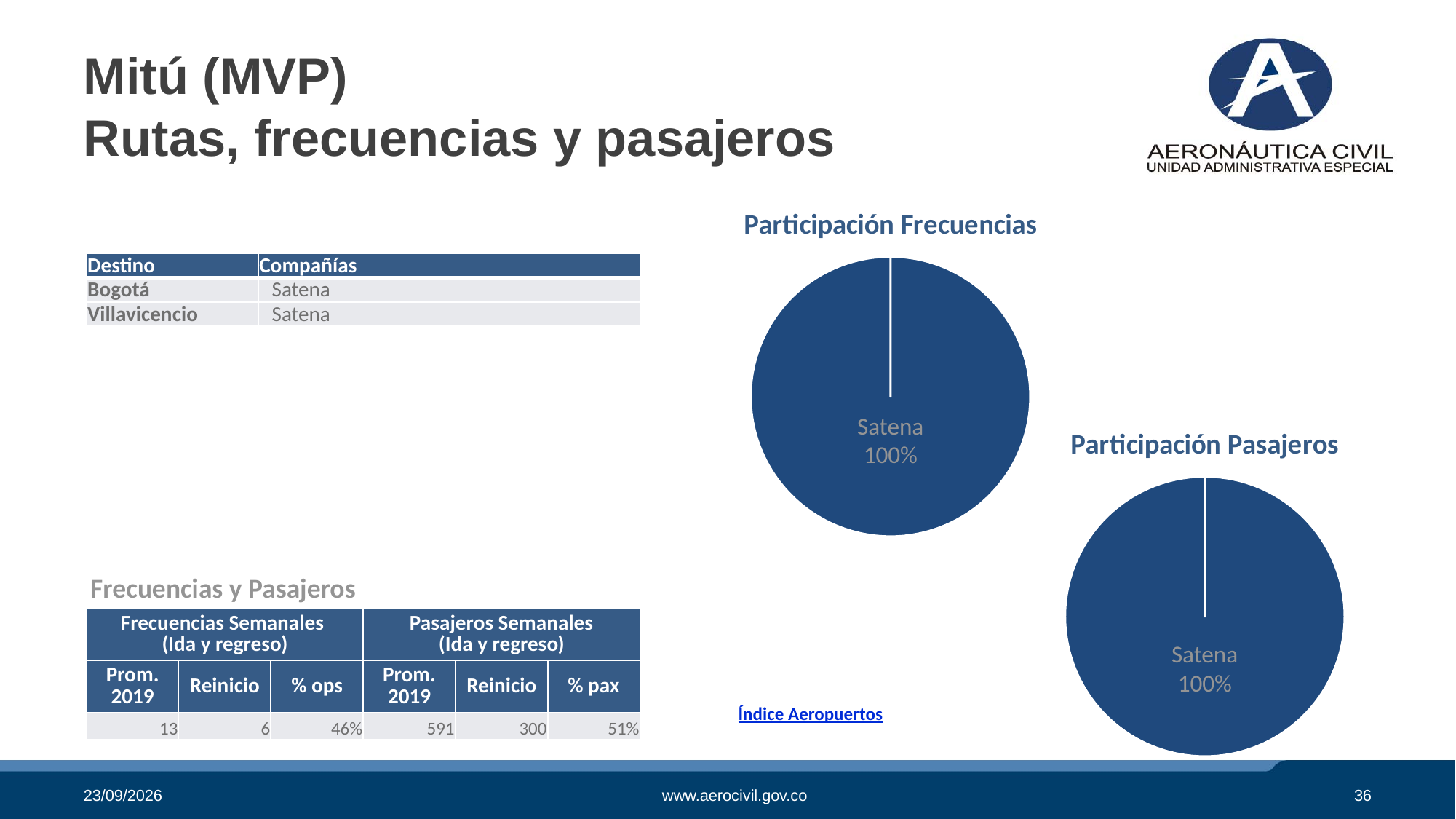
Which company is labelled in the 'Participación Pasajeros' pie chart? Satena In the 'Participación Pasajeros' chart, what share does Satena hold? 100% In the 'Participación Frecuencias' chart, what share does Satena hold? 100% How many slices does the 'Participación Pasajeros' pie chart show? 1 How many slices does the 'Participación Frecuencias' pie chart show? 1 What kind of chart is 'Participación Frecuencias'? Pie chart What is the title of the pie chart in the lower right of the slide? Participación Pasajeros What is the title of the pie chart in the upper right of the slide? Participación Frecuencias How many pie charts are shown on the slide? 2 What kind of chart is 'Participación Pasajeros'? Pie chart Which company is labelled in the 'Participación Frecuencias' pie chart? Satena